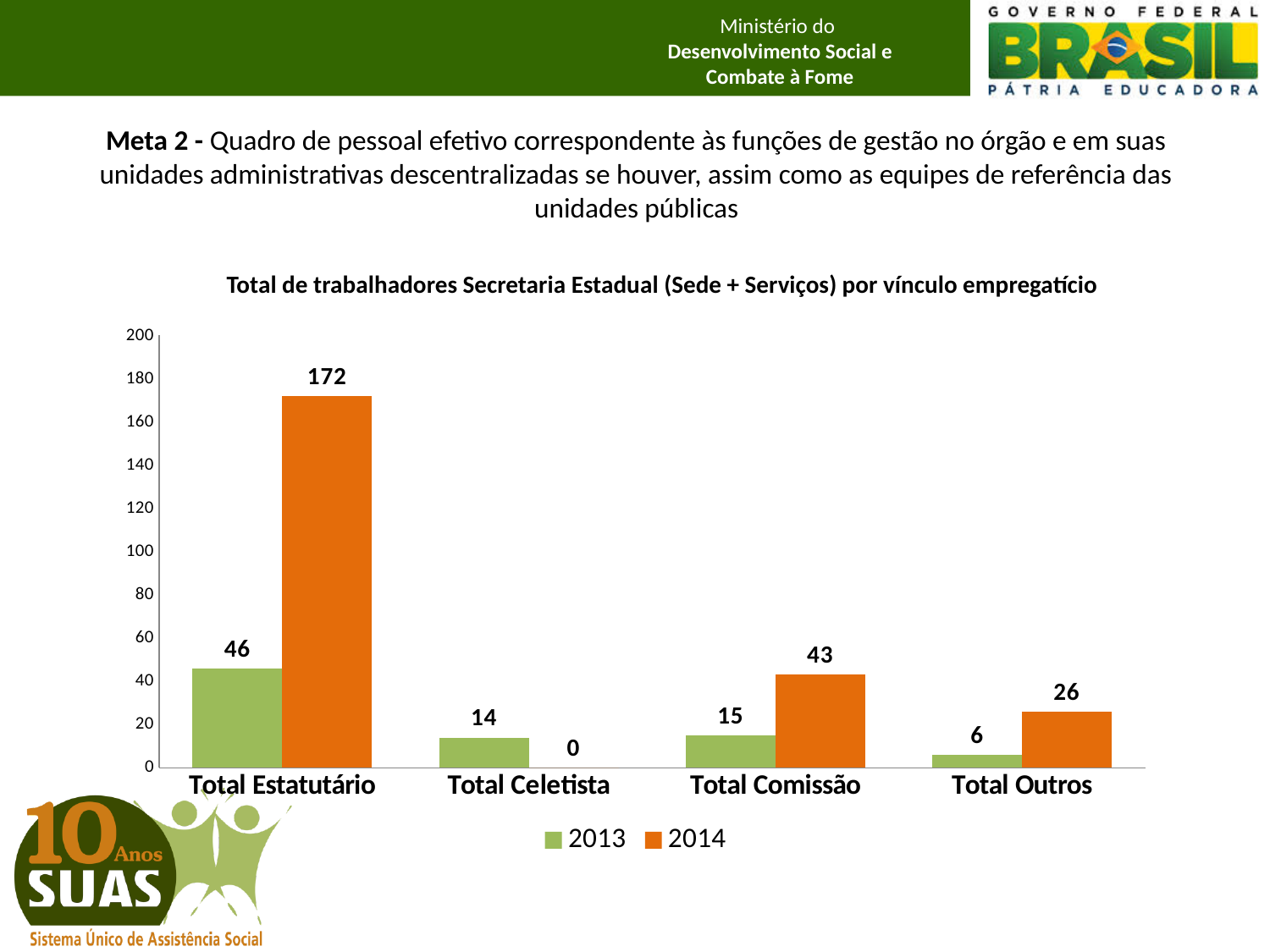
What is the title of the chart? Total de trabalhadores Secretaria Estadual (Sede + Serviços) por vínculo empregatício What is the value for Total Outros in 2014? 26 What is the difference between the 2014 and 2013 values for Total Estatutário? 126 Which is larger: the 2013 value for Total Celetista or the 2014 value for Total Celetista? 2013 What is the difference between the 2014 and 2013 values for Total Comissão? 28 What is the value for Total Celetista in 2013? 14 Which category has the lowest value for the 2013 series? Total Outros Which category has the highest value for the 2014 series? Total Estatutário How many categories are shown on the x axis? 4 What kind of chart is shown on the slide? bar chart What is the value for Total Estatutário in 2014? 172 How many series does the legend list? 2